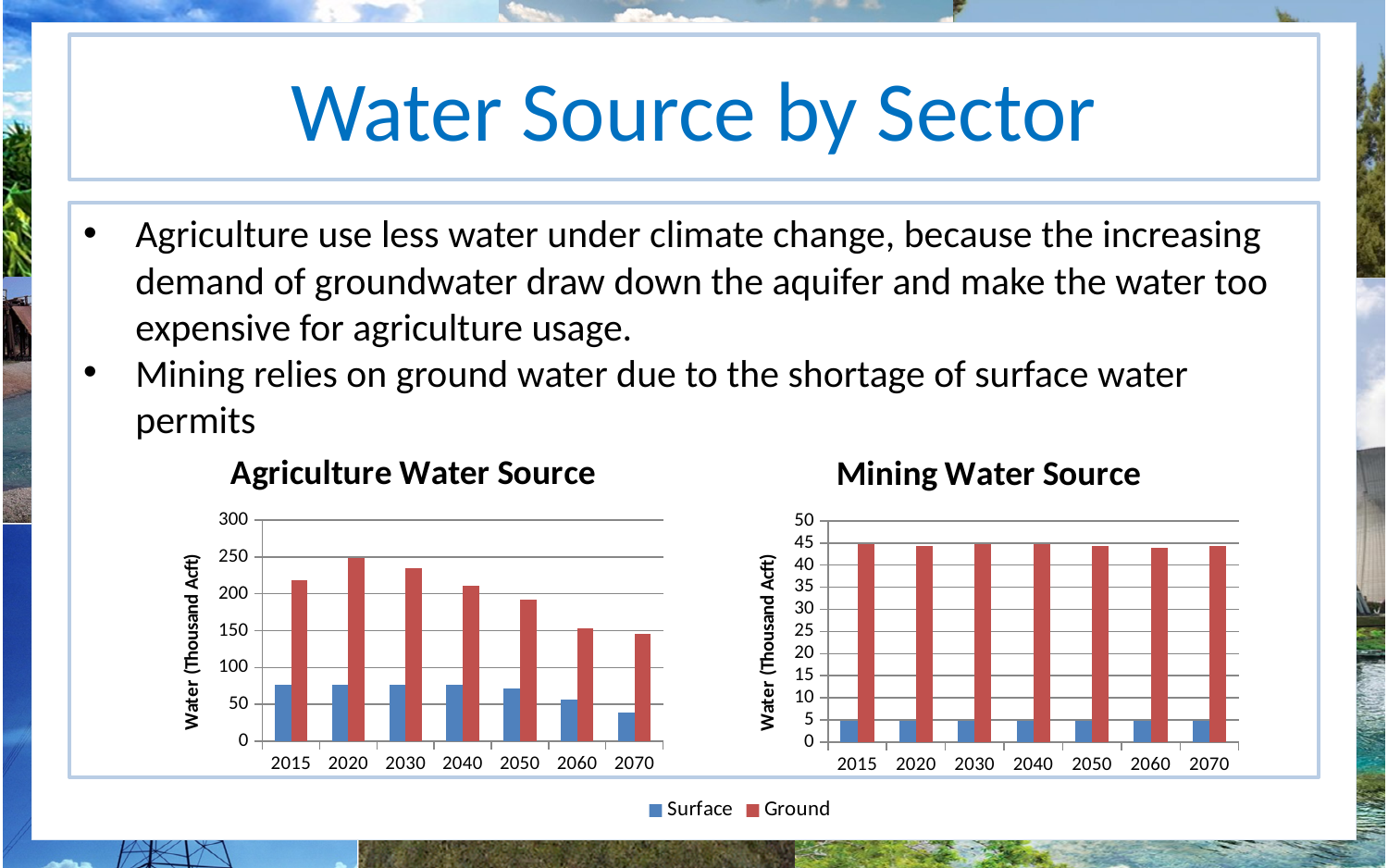
In the Agriculture Water Source chart, which year has the lowest Surface value? 2070 In the Mining Water Source chart, is the Ground value for 2015 greater or less than 40? greater In the Mining Water Source chart, is the Surface value for 2030 greater or less than 10? less How many series does the legend list for the charts? 2 What kind of chart is the Agriculture Water Source chart? bar chart In the Agriculture Water Source chart, which year has the highest Ground value? 2020 What is the y-axis label on the Mining Water Source chart? Water (Thousand Acft) In the Agriculture Water Source chart, is the Surface value for 2070 greater or less than 50? less How many years are shown on the x axis of the Mining Water Source chart? 7 In the Agriculture Water Source chart, do the Ground values rise or fall from 2020 to 2070? fall In the Mining Water Source chart, which is larger in 2040, Surface or Ground? Ground